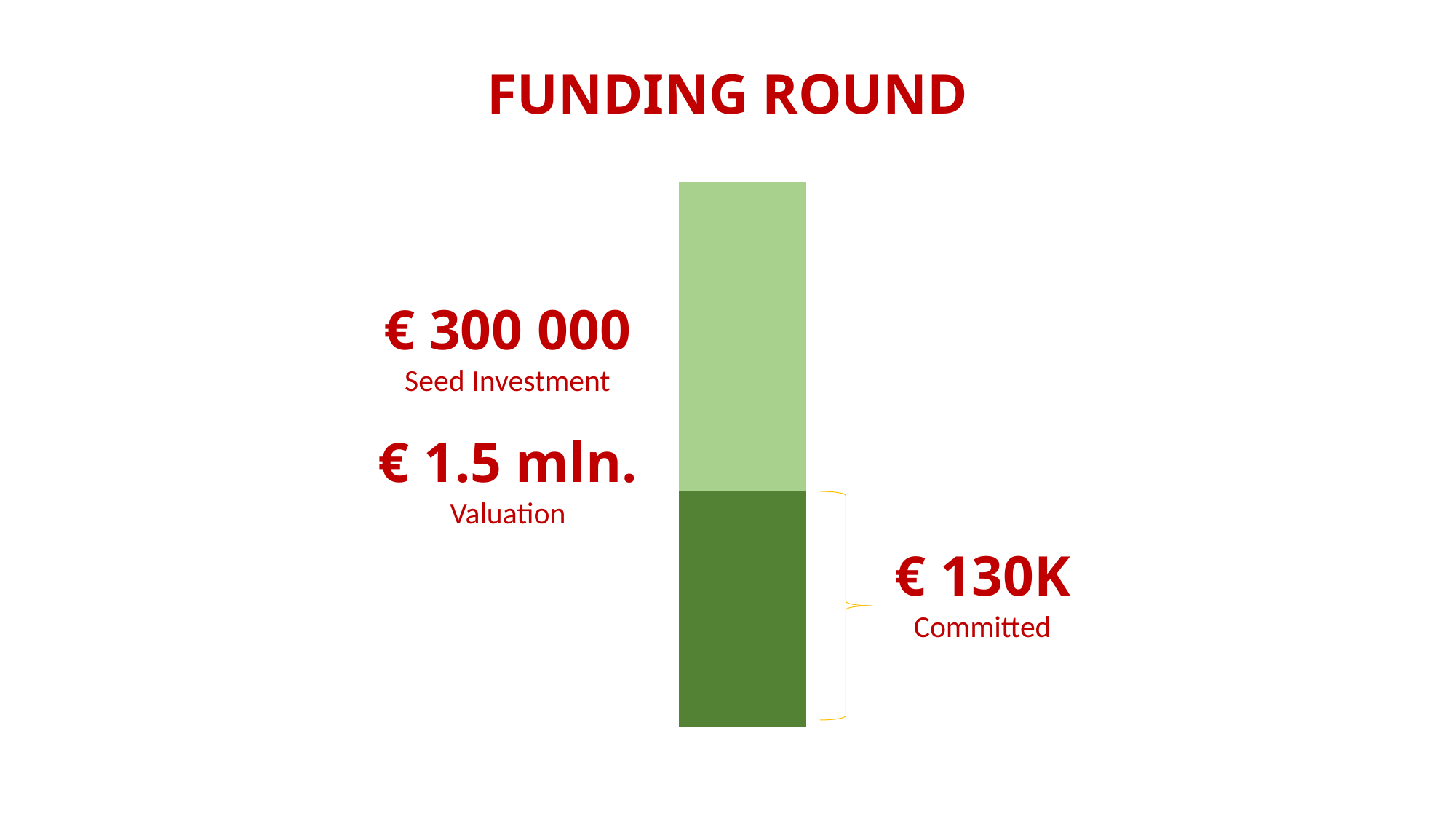
What Valuation is shown on the slide? € 1.5 mln. What is the Seed Investment amount shown on the slide? € 300 000 Which colour segment of the bar is marked as Committed? dark green What is the title of the chart on the slide? FUNDING ROUND How many coloured segments does the bar have? 2 Which is larger, the Seed Investment amount or the Committed amount? Seed Investment What amount is labelled as Committed on the chart? € 130K What kind of chart is shown on the slide? bar chart Is the Committed segment the upper or lower part of the bar? lower